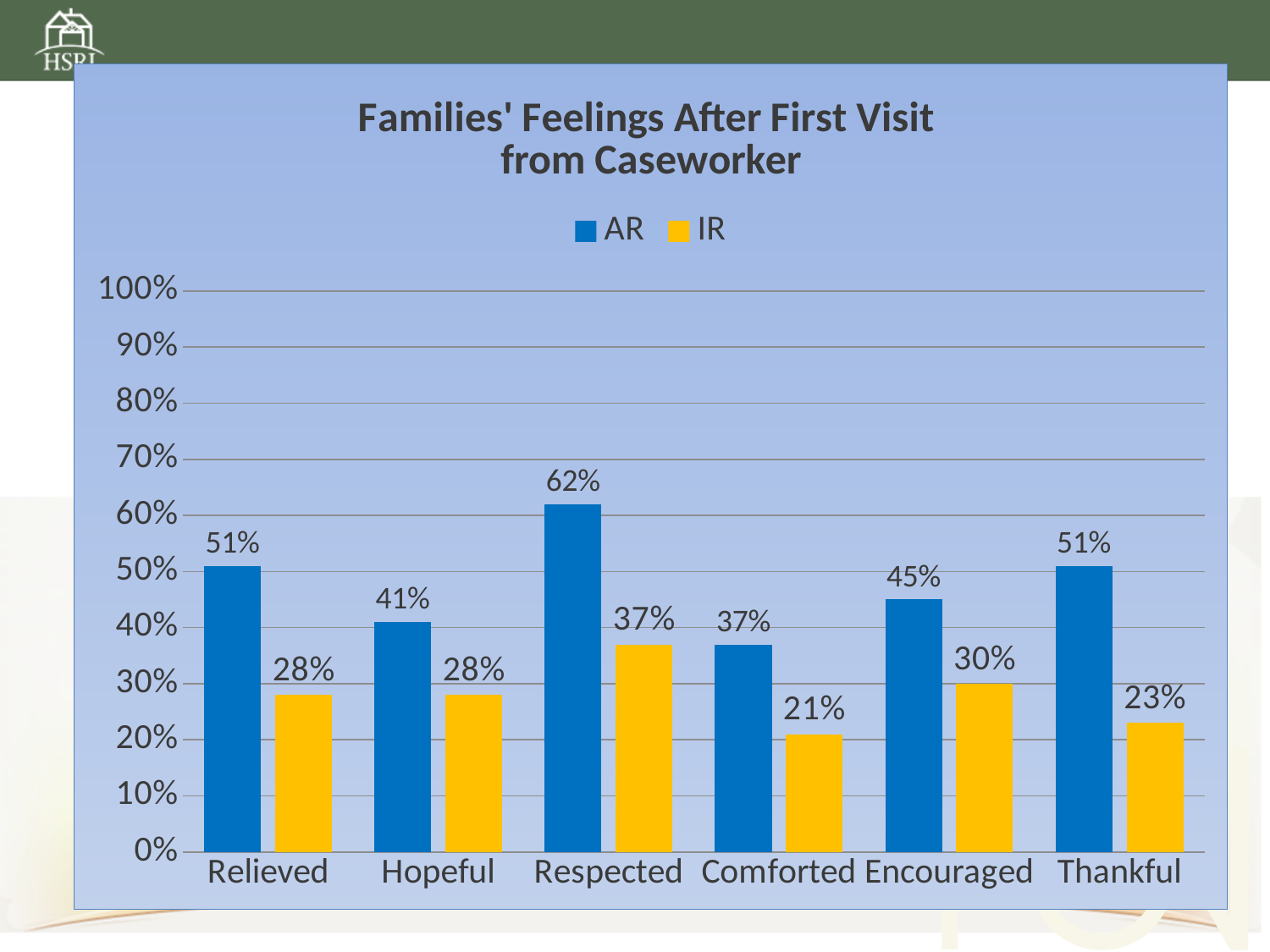
What is the title of the chart? Families' Feelings After First Visit from Caseworker What is the difference between the AR and IR values for Respected? 25% How many series does the legend list? 2 What is the IR value for Comforted? 21% How many categories are shown on the x axis? 6 Which category has the highest AR value? Respected Which category has the lowest IR value? Comforted What is the IR value for Encouraged? 30% What is the AR value for Respected? 62% Which is larger, the AR value for Hopeful or the AR value for Encouraged? Encouraged Which colour represents the IR series? Yellow What kind of chart is shown? Bar chart